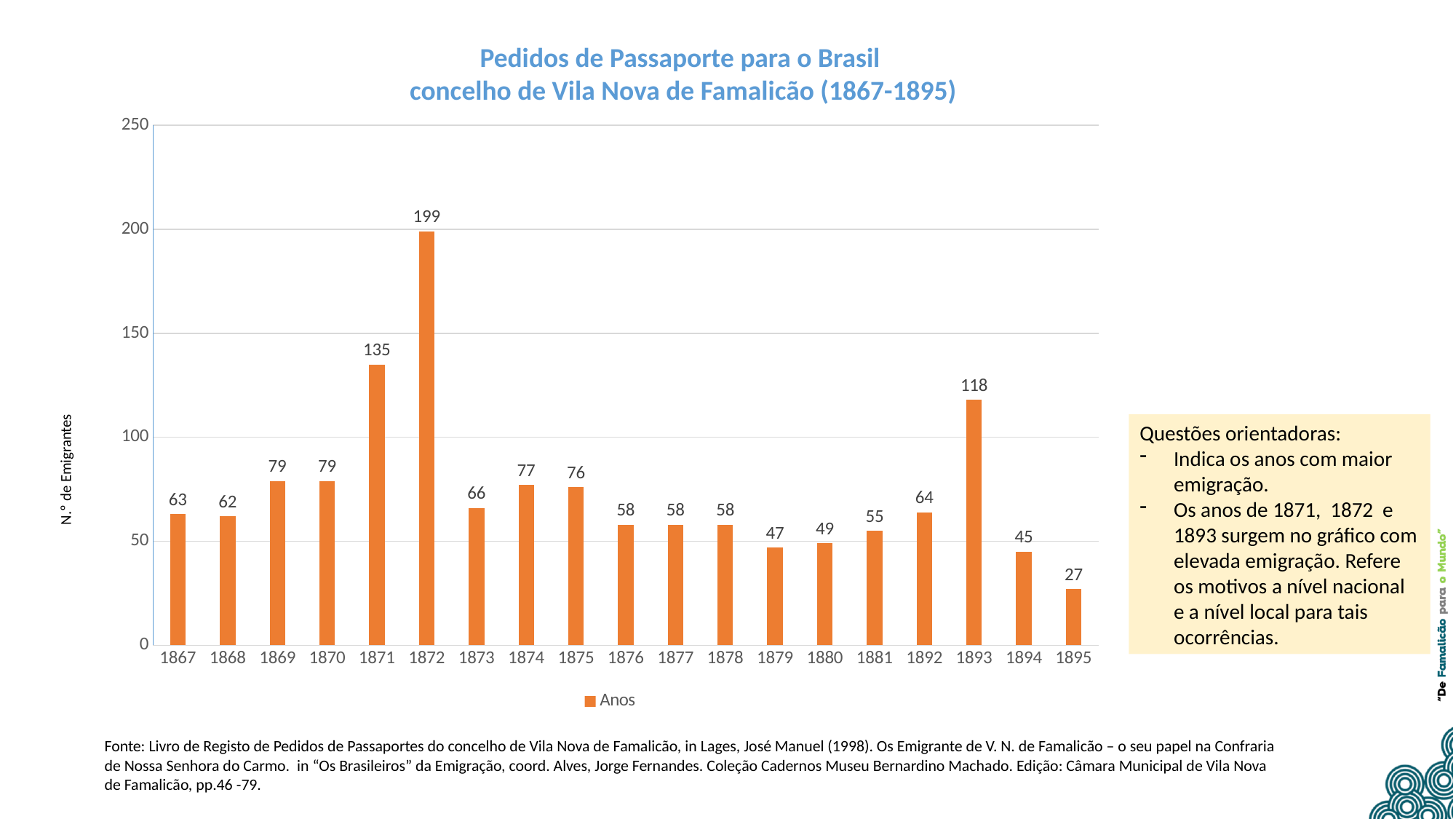
How many series does the legend list? 1 Which year has a larger value, 1893 or 1871? 1871 Which year has the highest number of emigrants? 1872 What is the number of emigrants for 1872? 199 How many years are shown on the x axis? 19 Which year has the lowest number of emigrants? 1895 Is the value for 1872 greater or less than 150? greater What is the label of the y axis? N.° de Emigrantes What kind of chart is shown on the slide? bar chart What is the number of emigrants for 1893? 118 What is the difference between the values for 1872 and 1871? 64 What is the number of emigrants for 1879? 47